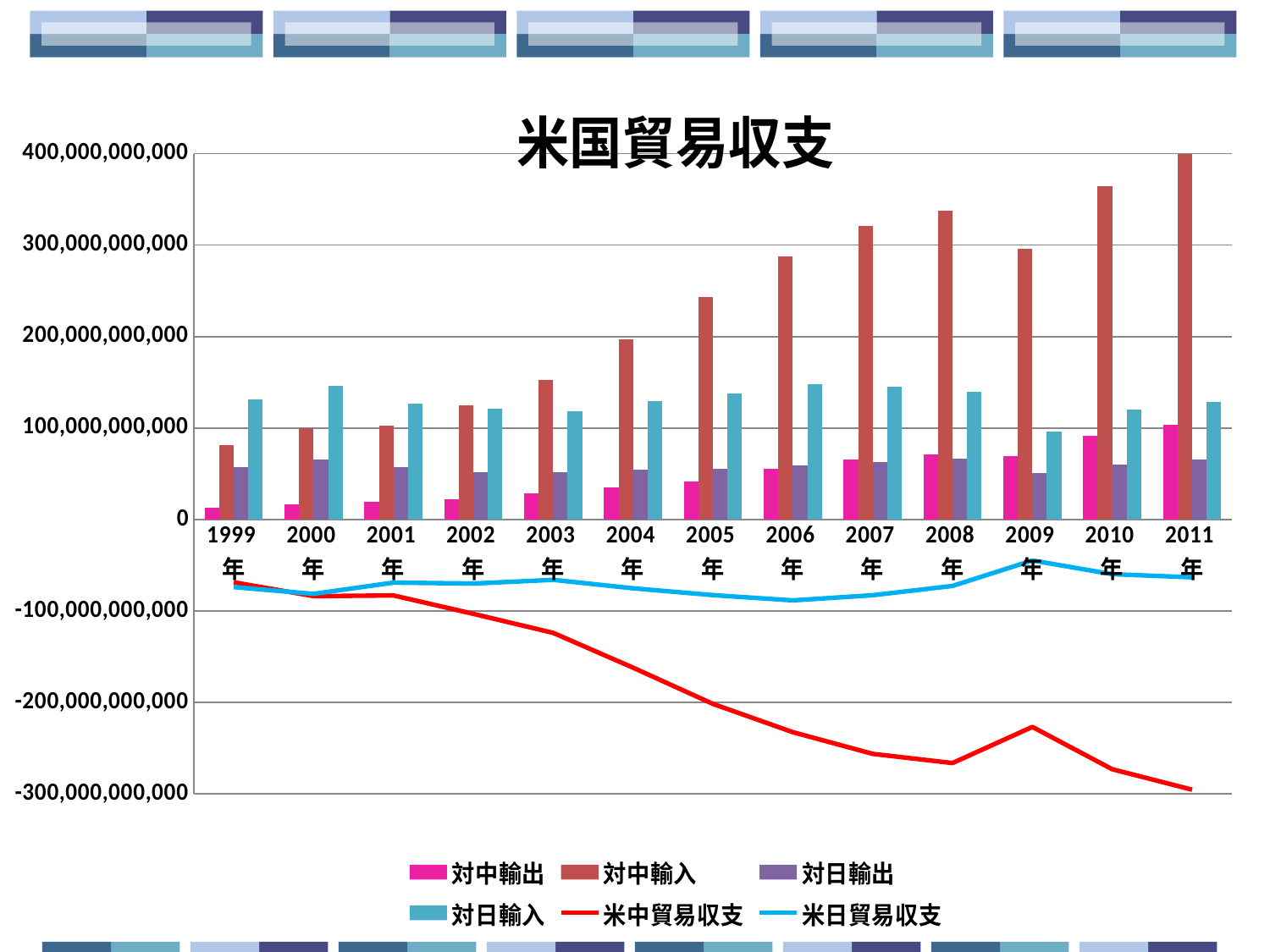
Is the value for 米中貿易収支 in 2011 greater or less than -200,000,000,000? less What is the title of the chart? 米国貿易収支 In which year is the 対中輸出 bar the lowest? 1999 In which year is the 対中輸入 bar the highest? 2011 In 1999, which is larger: 対中輸入 or 対日輸入? 対日輸入 How many series does the legend list? 6 Does the 米中貿易収支 line generally rise or fall from 1999 to 2011? fall In which year does the 米中貿易収支 line reach its lowest point? 2011 How many years are shown on the x axis? 13 Is the value for 対日輸入 in 2000 greater or less than 100,000,000,000? greater Is the value for 対中輸入 in 2007 greater or less than 300,000,000,000? greater What kind of chart is shown on the slide? A combined bar and line chart